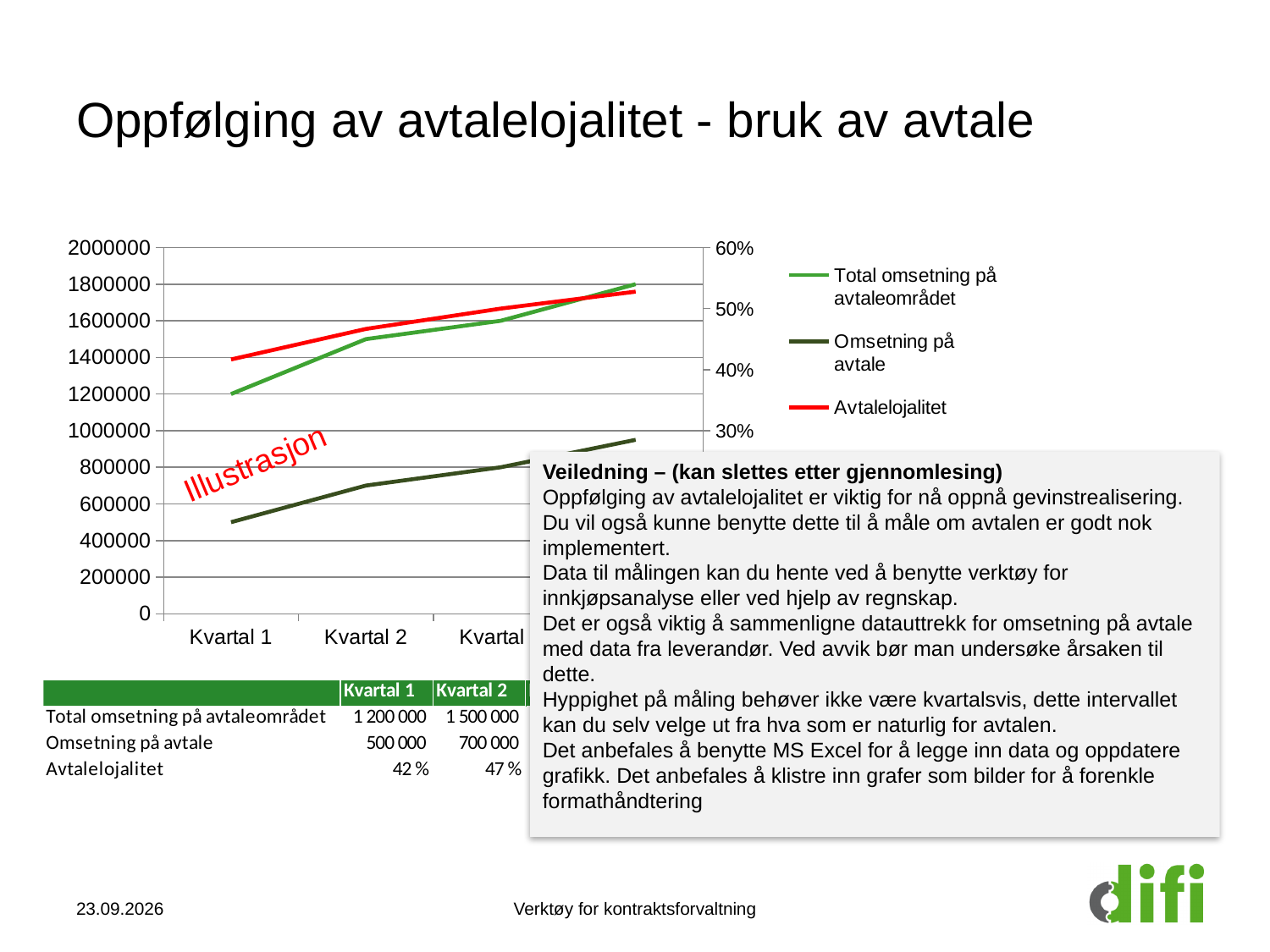
What is the value of Total omsetning på avtaleområdet in Kvartal 1? 1 200 000 What is the difference between Total omsetning på avtaleområdet and Omsetning på avtale in Kvartal 1? 700 000 What kind of chart is shown on the slide? line chart What colour is the Avtalelojalitet line in the chart? red What is the Avtalelojalitet value for Kvartal 1? 42 % Which quarter has the higher Avtalelojalitet, Kvartal 1 or Kvartal 2? Kvartal 2 What is the value of Omsetning på avtale in Kvartal 2? 700 000 Does the Total omsetning på avtaleområdet line rise or fall across the quarters? rise Is the value for Omsetning på avtale in Kvartal 1 greater or less than 600000? less Is the value for Total omsetning på avtaleområdet in Kvartal 2 greater or less than 1400000? greater By how much does Total omsetning på avtaleområdet increase from Kvartal 1 to Kvartal 2? 300 000 How many series does the chart legend list? 3